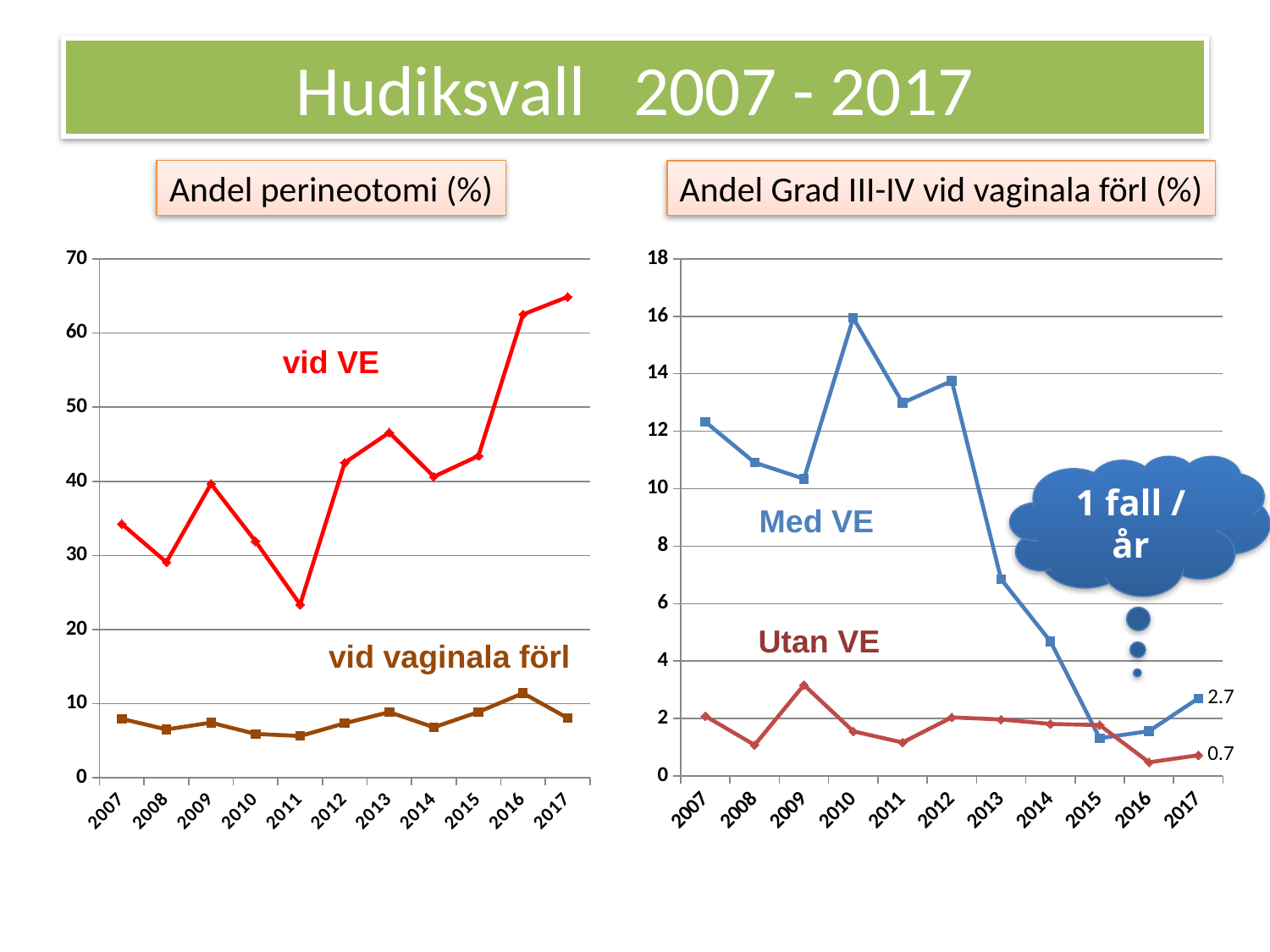
In the right chart "Andel Grad III-IV vid vaginala förl (%)", what is the difference between the Med VE and Utan VE values in 2017? 2.0 In the left chart "Andel perineotomi (%)", in which year is the vid VE series highest? 2017 In the left chart "Andel perineotomi (%)", in which year is the vid VE series lowest? 2011 In the right chart "Andel Grad III-IV vid vaginala förl (%)", is the value for Med VE in 2010 greater or less than 14? greater In the right chart "Andel Grad III-IV vid vaginala förl (%)", what is the value for Med VE in 2017? 2.7 In the right chart "Andel Grad III-IV vid vaginala förl (%)", in which year is the Med VE series highest? 2010 In the right chart "Andel Grad III-IV vid vaginala förl (%)", does the Med VE series rise or fall overall from 2007 to 2015? fall What type of chart is the left chart titled "Andel perineotomi (%)"? line chart In the right chart "Andel Grad III-IV vid vaginala förl (%)", which series has the larger value in 2017, Med VE or Utan VE? Med VE How many years are shown on the x axis of the left chart "Andel perineotomi (%)"? 11 In the left chart "Andel perineotomi (%)", is the value for vid VE in 2017 greater or less than 60? greater In the right chart "Andel Grad III-IV vid vaginala förl (%)", what is the value for Utan VE in 2017? 0.7